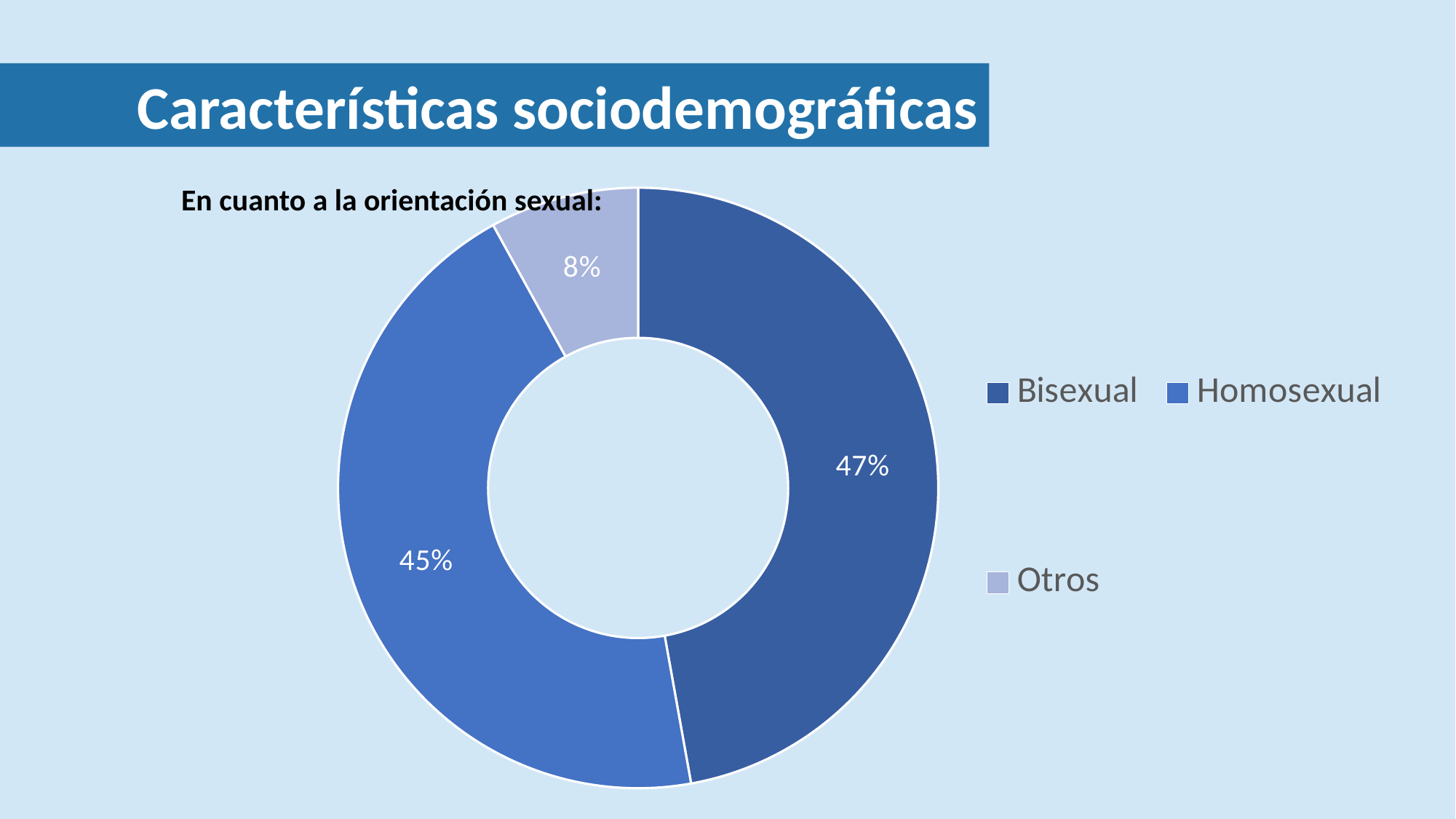
What is the difference in percentage points between the Bisexual and Homosexual shares? 2 Which share is larger, Bisexual or Homosexual? Bisexual Which category has the smallest share of the chart? Otros How many categories does the chart show? 3 What percentage of the doughnut chart is labelled Homosexual? 45% What percentage of the doughnut chart is labelled Otros? 8% What is the title of the slide? Características sociodemográficas What kind of chart is shown on the slide? doughnut chart Which category has the largest share of the chart? Bisexual What percentage of the doughnut chart is labelled Bisexual? 47% What text introduces the chart below the slide title? En cuanto a la orientación sexual: What is the difference in percentage points between the Homosexual and Otros shares? 37